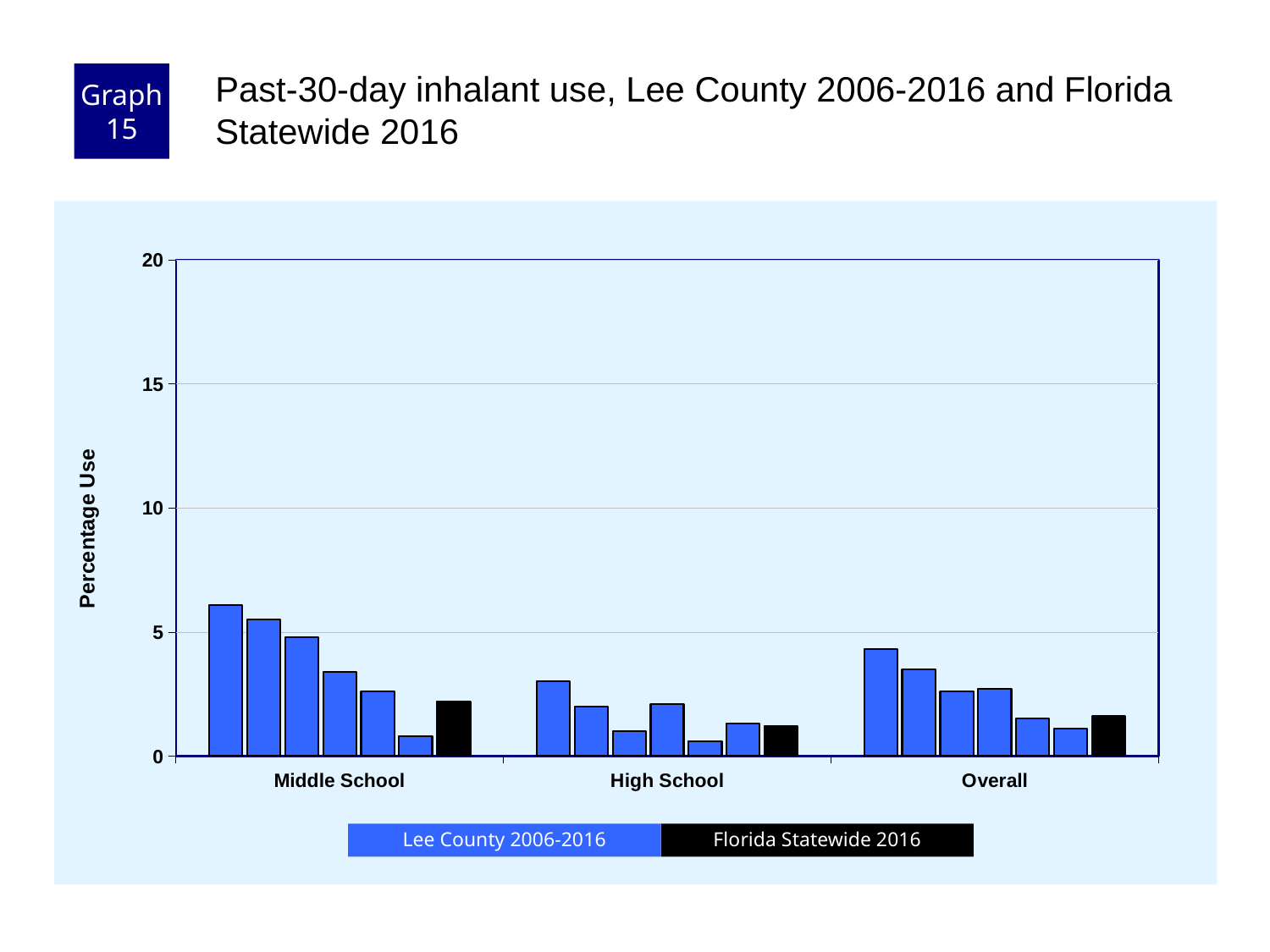
Which is larger: the Florida Statewide 2016 bar for Middle School or the Florida Statewide 2016 bar for High School? Middle School How many series does the legend list? 2 Which category has the tallest bar overall: Middle School, High School, or Overall? Middle School Is the value of the tallest Middle School bar greater or less than 5? greater What are the two series named in the legend? Lee County 2006-2016 and Florida Statewide 2016 Is the value of the tallest High School bar greater or less than 5? less What is the label on the y axis? Percentage Use How many school-level categories are shown on the x axis? 3 Is the Florida Statewide 2016 value for Middle School greater or less than 5? less Do the Lee County bars for Middle School rise or fall from left to right? fall What kind of chart is shown on the slide? bar chart